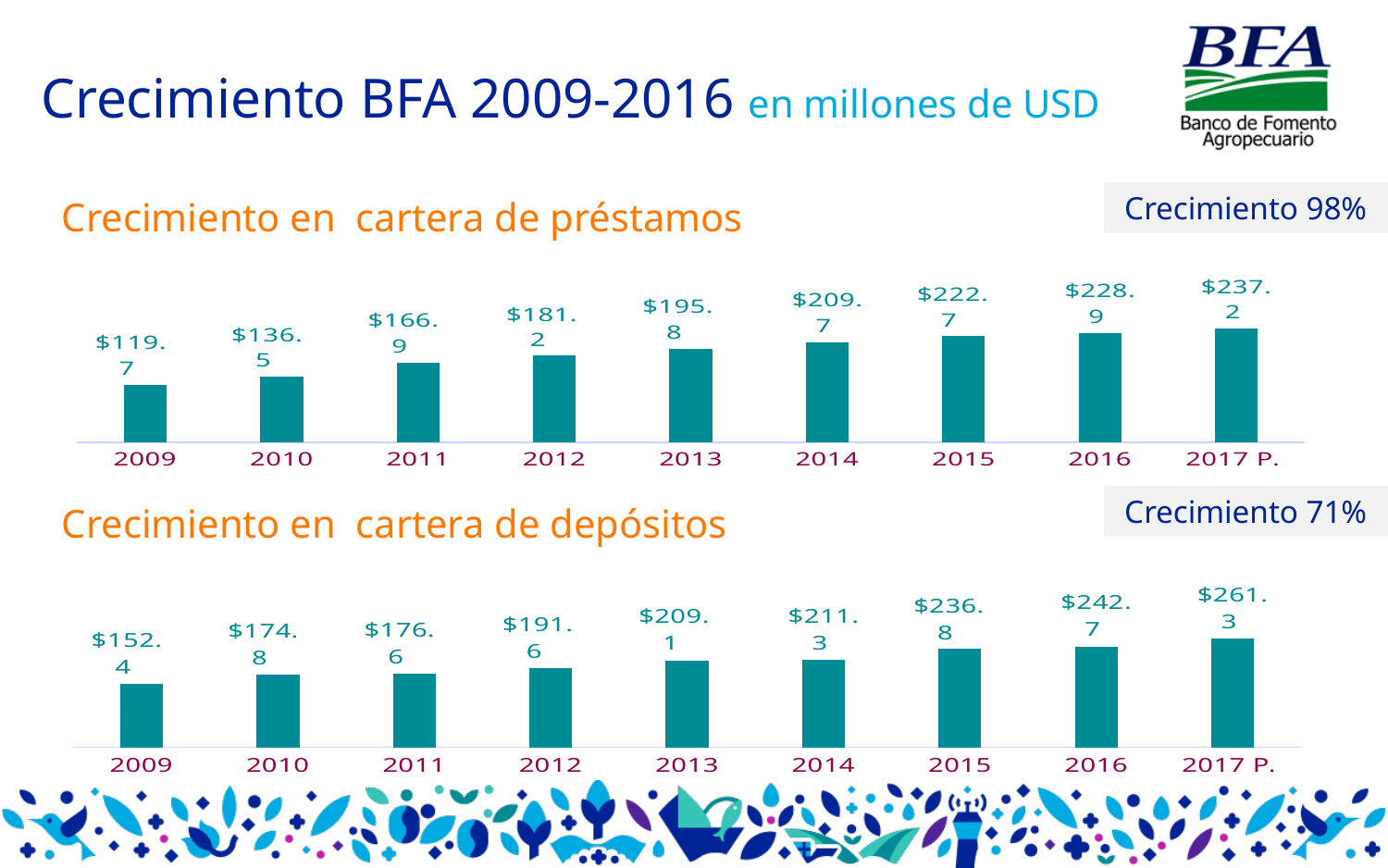
In the 'Crecimiento en cartera de depósitos' chart, what is the value for 2013? $209.1 In the 'Crecimiento en cartera de préstamos' chart, do the values rise or fall from 2009 to 2017 P.? Rise Which is larger: the 2012 value in the 'Crecimiento en cartera de préstamos' chart or the 2012 value in the 'Crecimiento en cartera de depósitos' chart? Depósitos ($191.6) In the 'Crecimiento en cartera de préstamos' chart, what is the value for 2016? $228.9 What type of chart is the 'Crecimiento en cartera de depósitos' chart? Bar chart In the 'Crecimiento en cartera de préstamos' chart, which year has the highest value? 2017 P. In the 'Crecimiento en cartera de préstamos' chart, what is the value for 2009? $119.7 In the 'Crecimiento en cartera de depósitos' chart, what is the value for 2017 P.? $261.3 How many years are shown on the x axis of the 'Crecimiento en cartera de préstamos' chart? 9 In the 'Crecimiento en cartera de préstamos' chart, what is the difference between the values for 2017 P. and 2009? $117.5 In the 'Crecimiento en cartera de depósitos' chart, which year has the lowest value? 2009 In the 'Crecimiento en cartera de depósitos' chart, what is the difference between the values for 2015 and 2014? $25.5